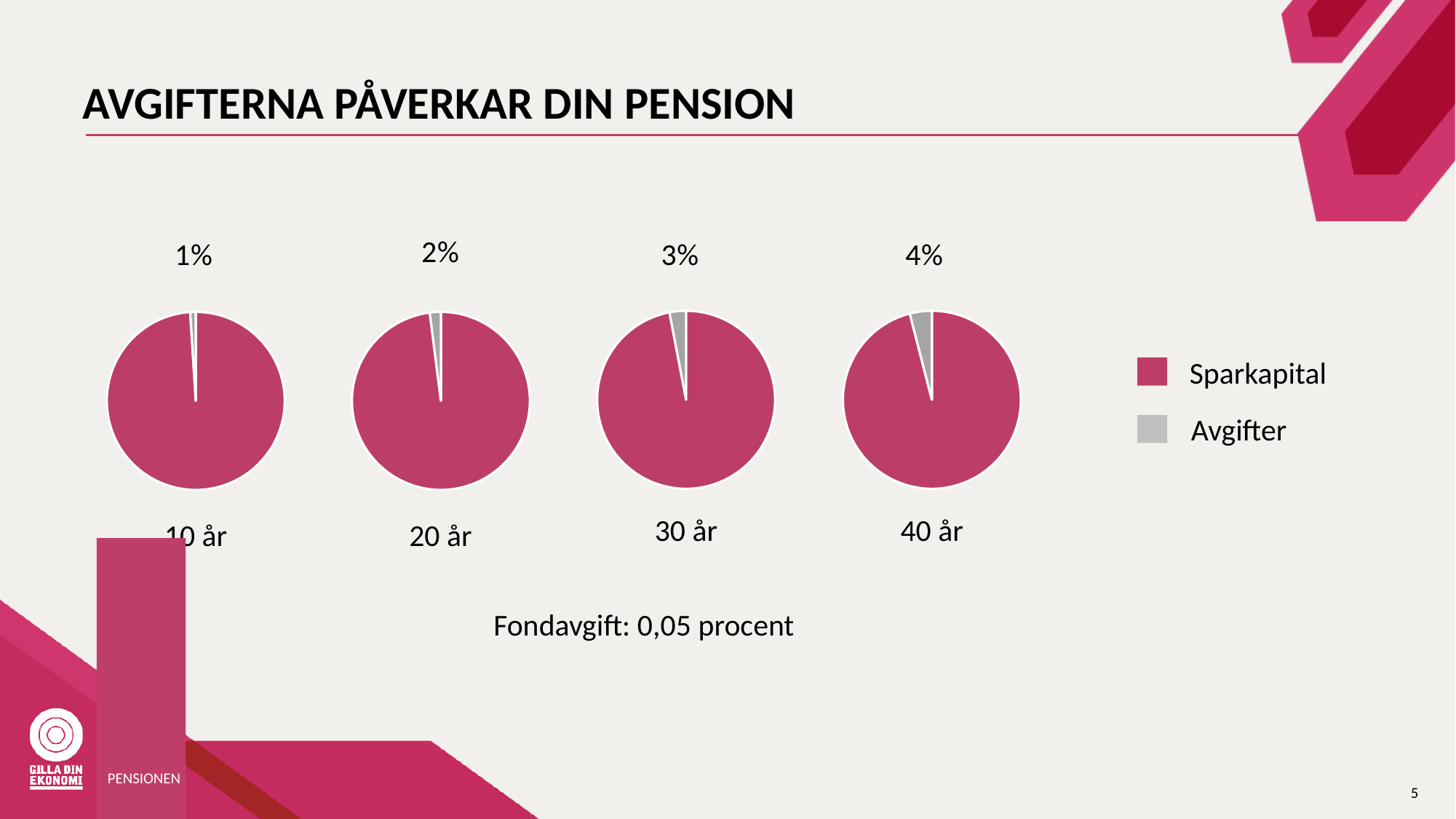
In the pie chart labelled 20 år, what percentage is shown above the chart? 2% In the pie chart labelled 30 år, what percentage is shown above the chart? 3% Which pie chart has the smallest Avgifter slice? 10 år Does the Avgifter share rise or fall as the number of years increases from 10 år to 40 år? Rise In the pie chart labelled 10 år, what percentage is shown above the chart? 1% In the pie chart labelled 40 år, what percentage is shown above the chart? 4% Which pie chart has the largest Avgifter slice? 40 år What kind of charts are shown on the slide? Pie charts How many series does the legend list? 2 Is the Avgifter slice larger in the 30 år pie chart or the 20 år pie chart? 30 år Which legend entry is shown in grey? Avgifter How many pie charts are shown on the slide? 4